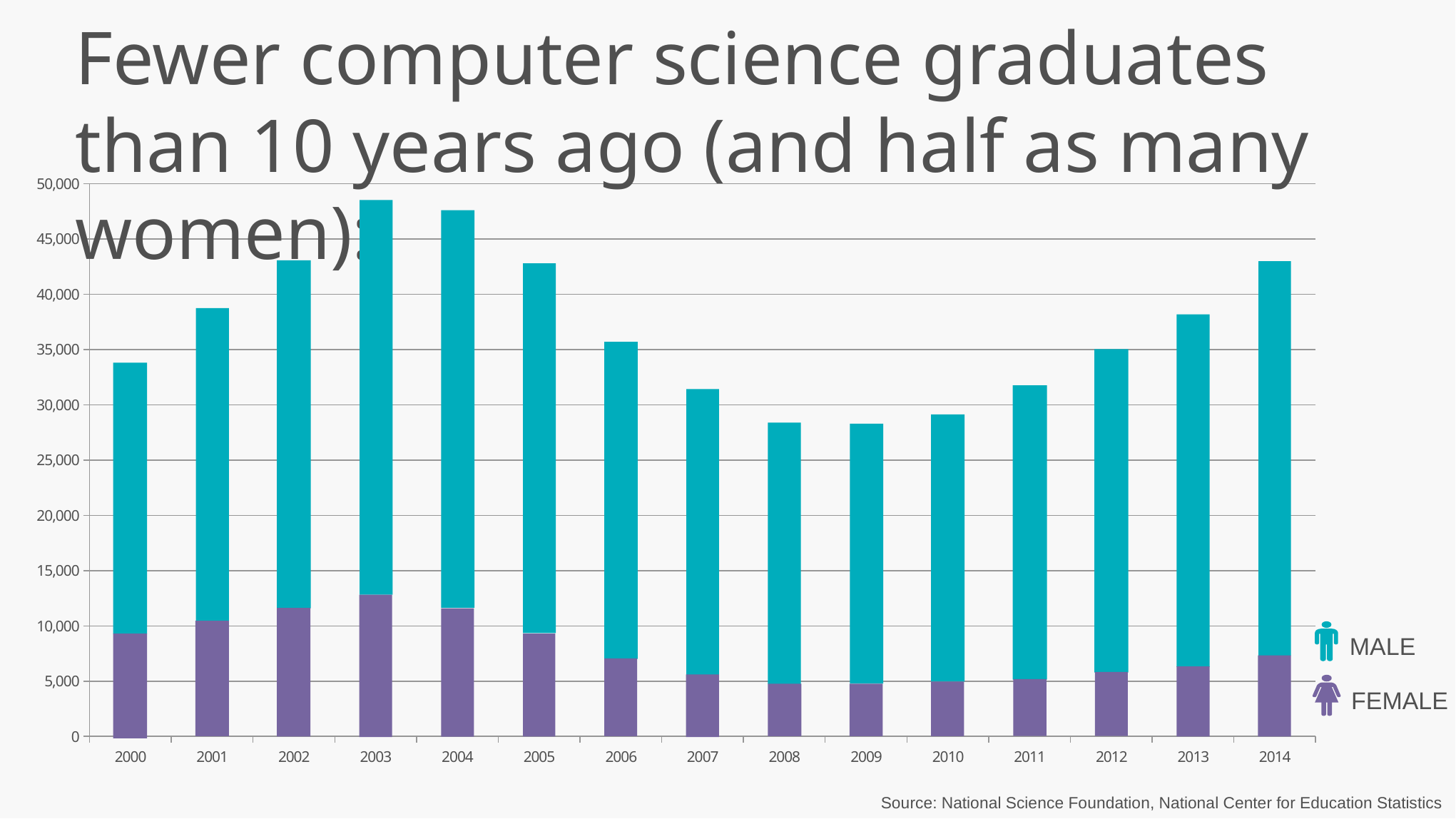
Is the number of female graduates in 2003 greater or less than 10,000? greater Is the total number of graduates in 2008 greater or less than 30,000? less How many series does the legend list? 2 Do total graduate numbers rise or fall from 2003 to 2009? fall Is the total number of graduates in 2014 greater or less than 40,000? greater What kind of chart is shown on the slide? Stacked bar chart Which year has the larger total number of graduates, 2005 or 2006? 2005 Which year has the highest number of female graduates? 2003 Which series is shown in purple in the legend? FEMALE Which year has the highest total number of graduates? 2003 How many years are shown along the x axis? 15